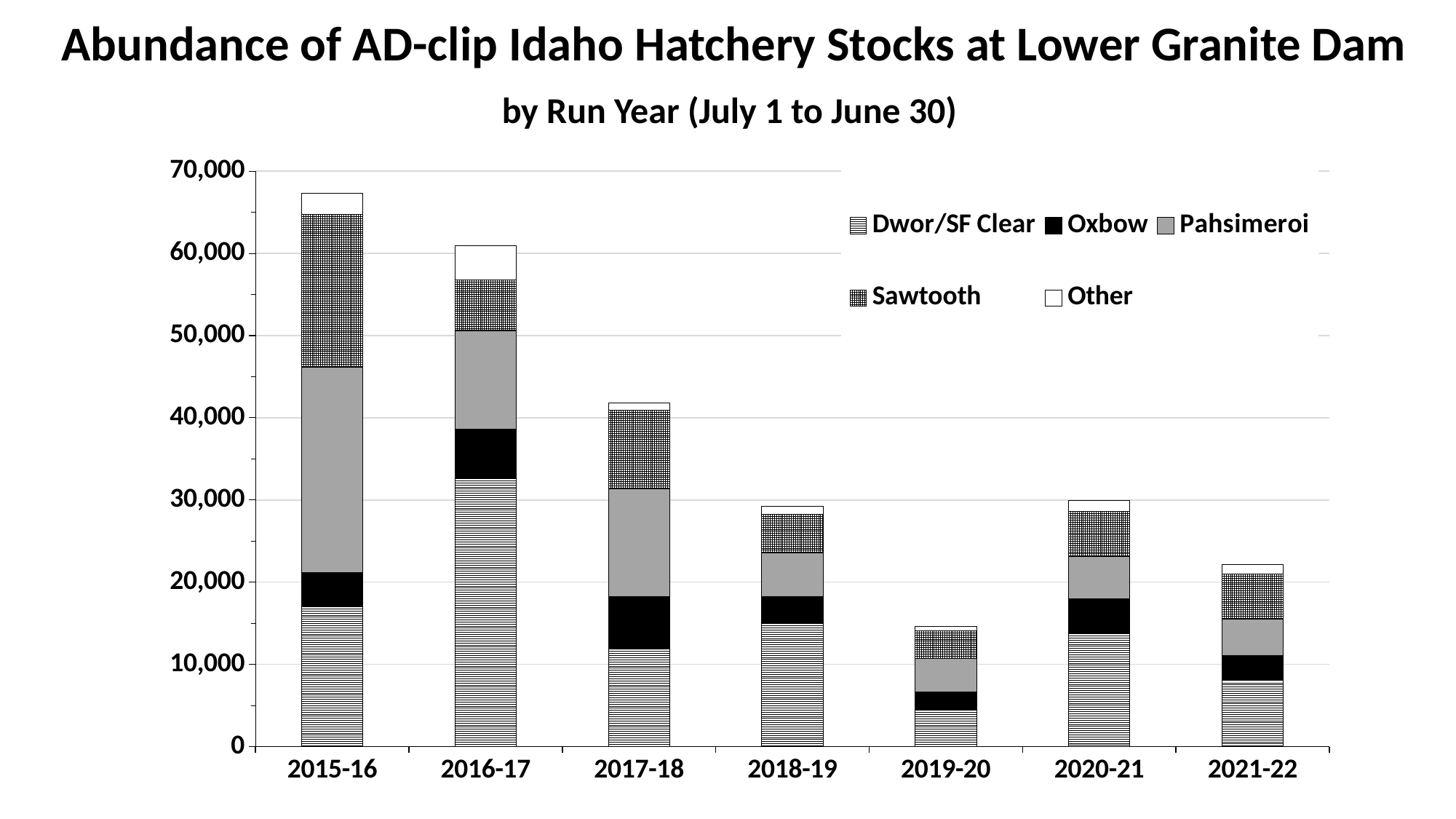
How many run years are shown on the x axis? 7 Which run year has the larger total abundance, 2017-18 or 2018-19? 2017-18 How many series does the legend list? 5 Which run year has the highest total abundance? 2015-16 Which run year has the lowest total abundance? 2019-20 Which run year has the larger total abundance, 2020-21 or 2021-22? 2020-21 Is the total abundance for 2019-20 greater or less than 20,000? less Which series is shown in solid black in the legend? Oxbow Is the total abundance for 2017-18 greater or less than 40,000? greater Do the total abundances rise or fall from 2015-16 to 2019-20? fall Is the total abundance for 2015-16 greater or less than 60,000? greater What kind of chart is shown on the slide? Stacked bar chart